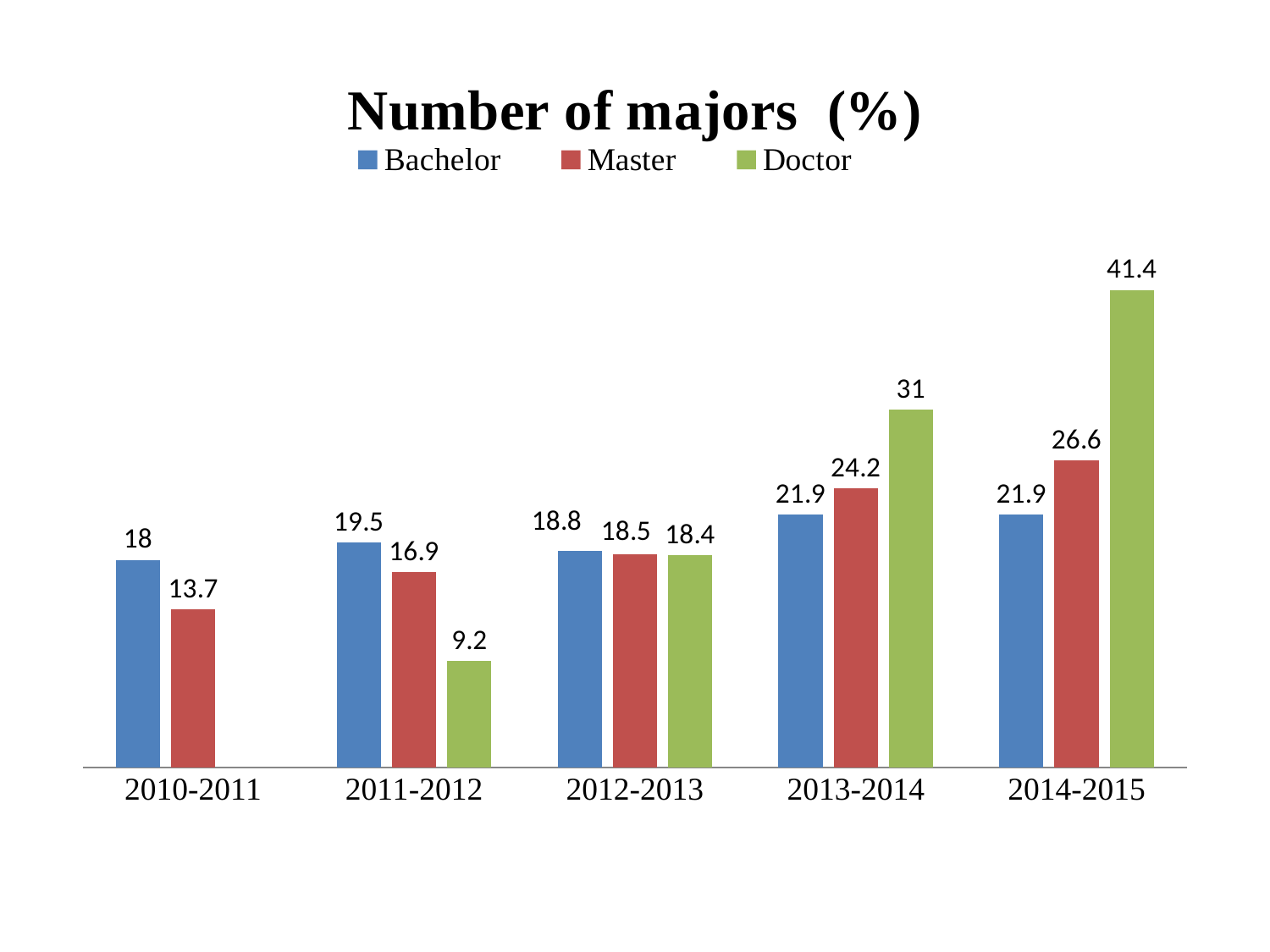
How many series does the legend list? 3 What is the difference between the Master values in 2013-2014 and 2012-2013? 5.7 What kind of chart is this? Bar chart What is the Master value for 2010-2011? 13.7 How many year categories are shown on the x axis? 5 Does the Doctor series rise or fall from 2011-2012 to 2014-2015? Rise Which year has the highest Doctor value? 2014-2015 Which year has the lowest Master value? 2010-2011 Which is larger in 2011-2012, the Bachelor value or the Doctor value? Bachelor What is the Doctor value for 2014-2015? 41.4 What is the Bachelor value for 2012-2013? 18.8 What is the difference between the Doctor and Bachelor values in 2014-2015? 19.5